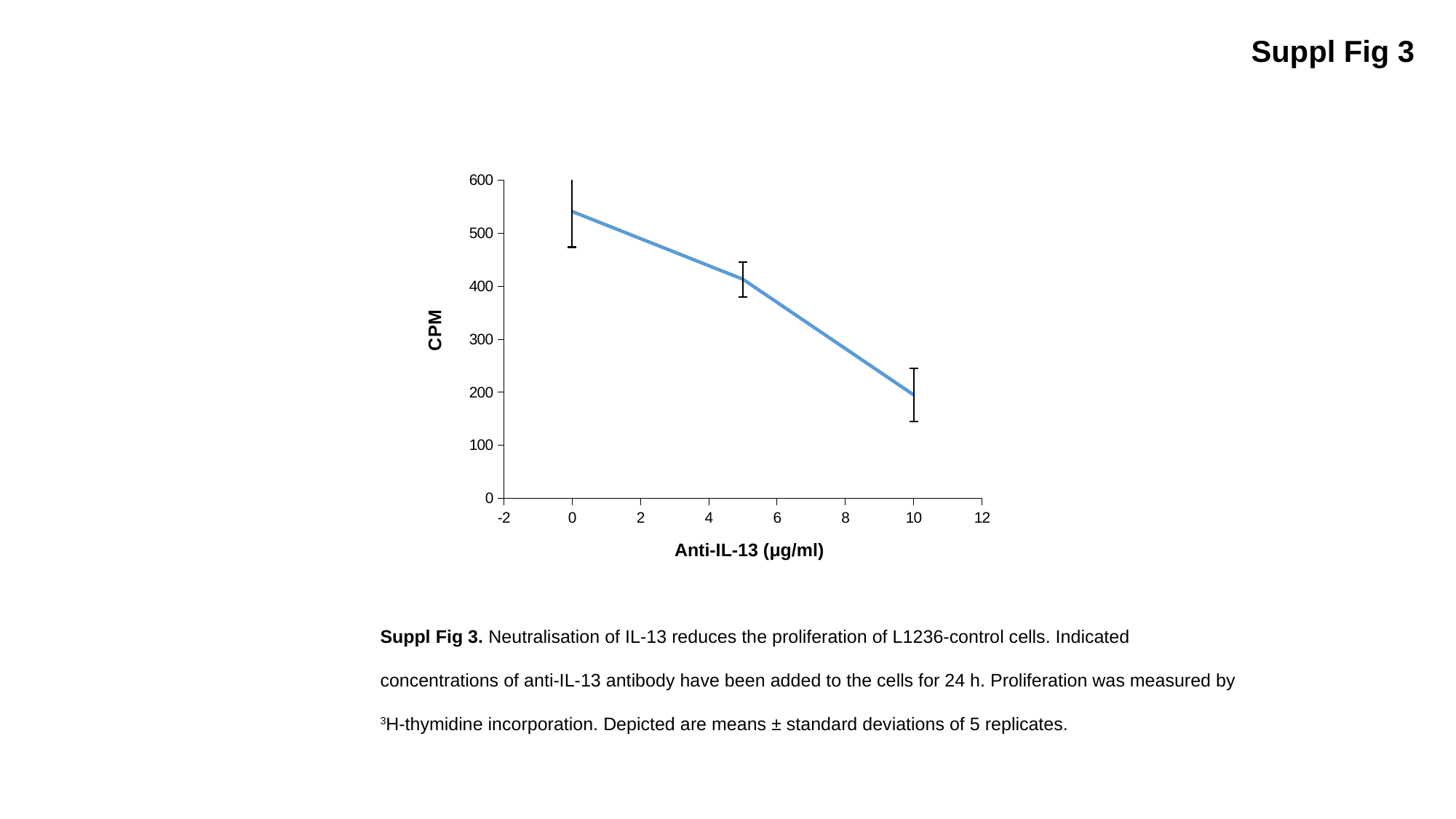
Is the CPM value at 0 µg/ml anti-IL-13 greater or less than 500? greater Is the CPM value at 10 µg/ml anti-IL-13 greater or less than 300? less Which has the larger CPM value: 0 µg/ml or 10 µg/ml anti-IL-13? 0 µg/ml What is the label of the x axis? Anti-IL-13 (µg/ml) Do the CPM values rise or fall as the anti-IL-13 concentration increases along the x axis? fall At which anti-IL-13 concentration is the CPM value highest? 0 µg/ml Which has the larger CPM value: 5 µg/ml or 10 µg/ml anti-IL-13? 5 µg/ml How many data points are plotted on the line? 3 Is the CPM value at 5 µg/ml anti-IL-13 greater or less than 500? less At which anti-IL-13 concentration is the CPM value lowest? 10 µg/ml What kind of chart is shown on the slide? line chart What is the label of the y axis? CPM